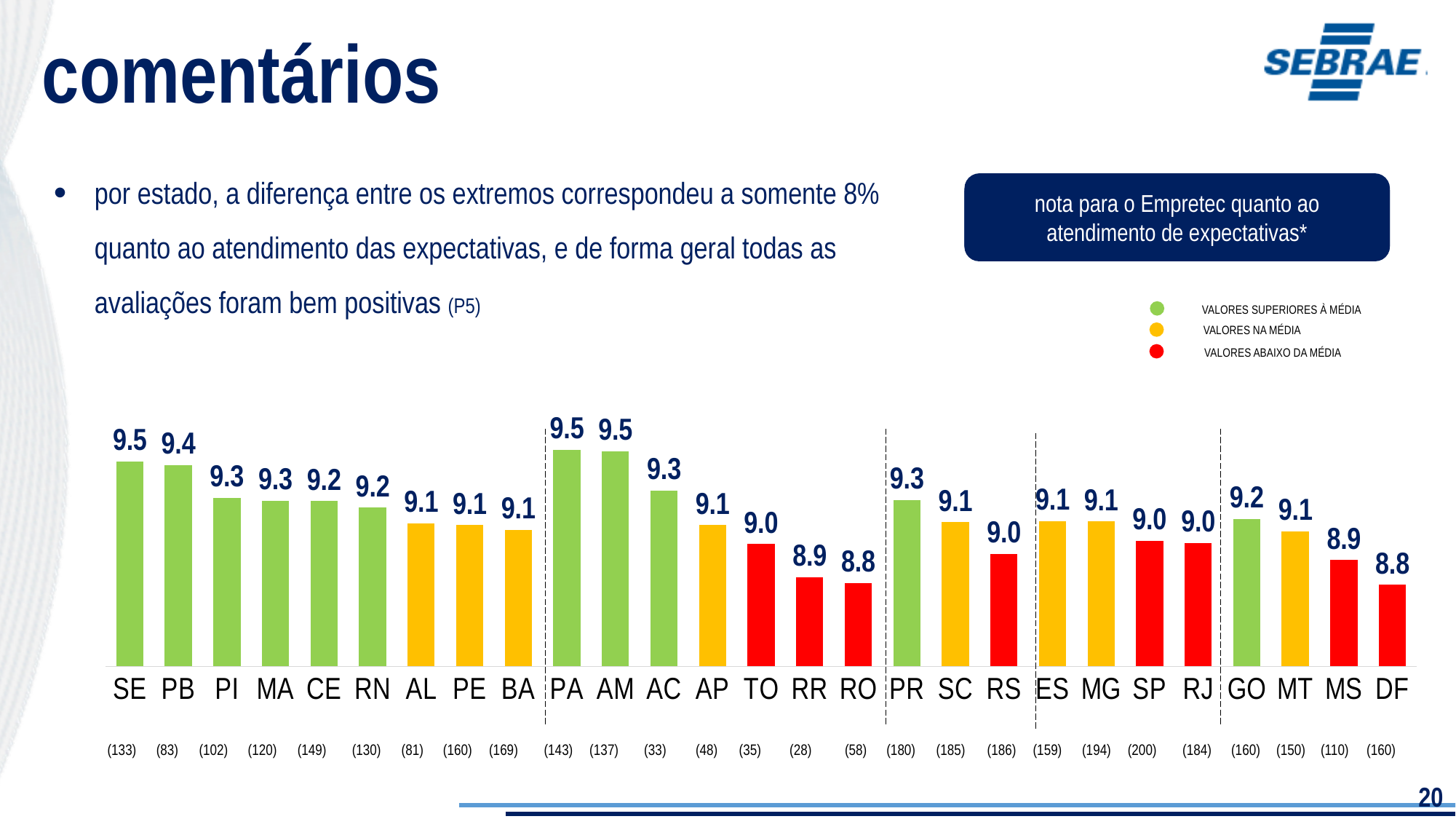
Among GO, MT, MS and DF, which state has the lowest value? DF How many states (bars) are shown in the chart? 27 What is the value shown for MT? 9.1 Which has a higher value, CE or SP? CE What is the value shown for PR? 9.3 What is the difference between the values for PB and RR? 0.5 Which has a higher value, MS or GO? GO What is the value shown for RO? 8.8 What kind of chart is shown on the slide? Bar chart What is the difference between the values for AM and DF? 0.7 How many colour categories does the legend list? 3 What is the value shown for SE? 9.5